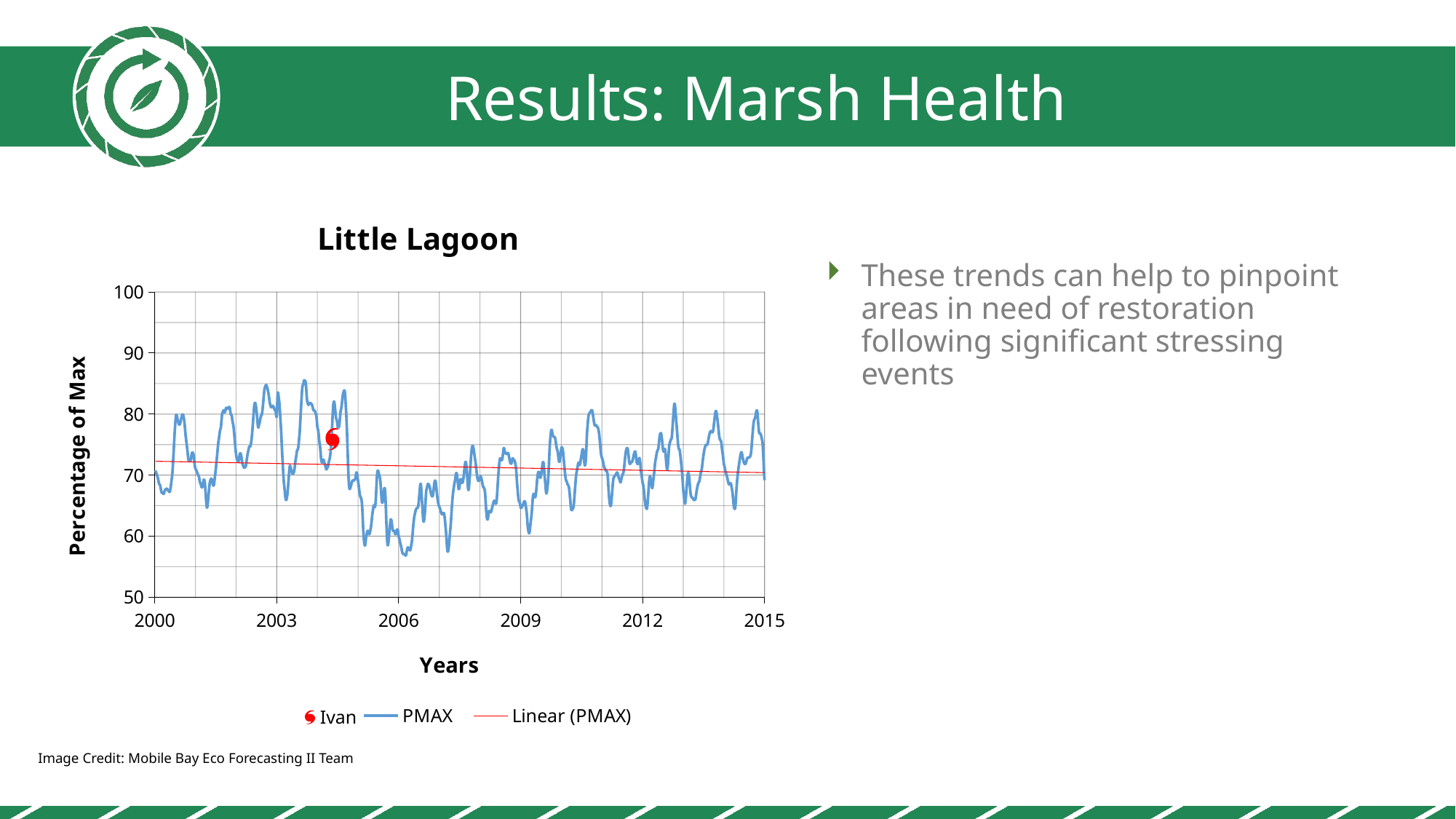
What type of chart is shown on the slide? line chart Is the highest PMAX value on the chart greater or less than 80? greater What is the title of the chart? Little Lagoon Which year is the Ivan marker placed closest to on the x-axis: 2003 or 2009? 2003 How many entries does the chart legend list? 3 Is the highest PMAX value on the chart greater or less than 90? less How many year tick labels are shown on the x-axis? 6 What is the label of the y-axis? Percentage of Max Does the Linear (PMAX) trend line rise or fall from 2000 to 2015? fall Is the PMAX value at the start of 2000 greater or less than 60? greater